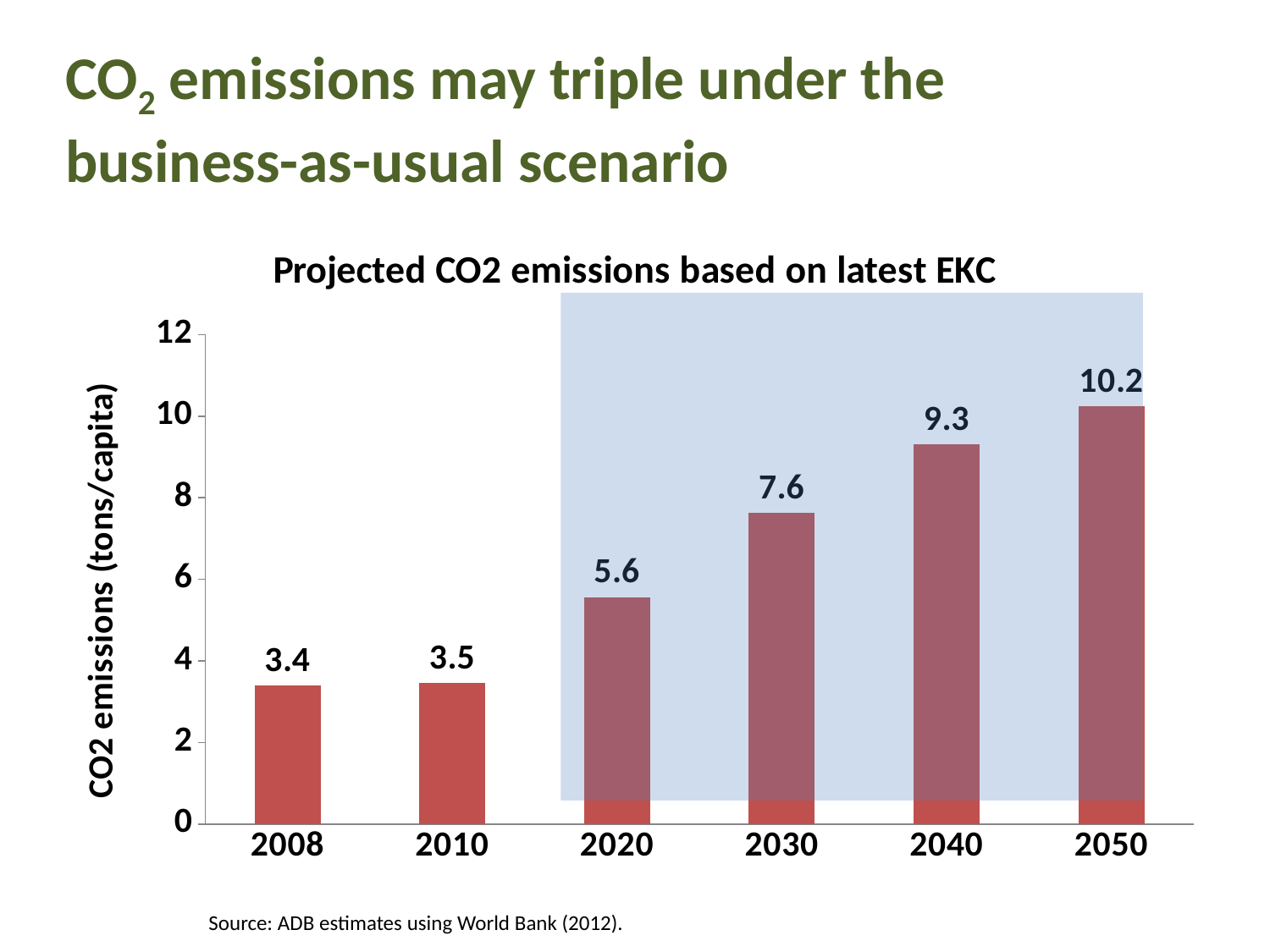
What is the projected CO2 emissions value for 2030? 7.6 What is the difference between the values for 2040 and 2020? 3.7 Which is larger, the value for 2020 or the value for 2030? 2030 What is the difference between the CO2 emissions values for 2050 and 2008? 6.8 What is the projected CO2 emissions value for 2050? 10.2 Do the CO2 emissions values rise or fall from 2008 to 2050? Rise What is the CO2 emissions value for 2008? 3.4 Which year has the highest CO2 emissions value? 2050 What kind of chart is shown on the slide? Bar chart Is the value for 2040 greater or less than 8? greater Which year has the lowest CO2 emissions value? 2008 How many years are shown on the x axis? 6